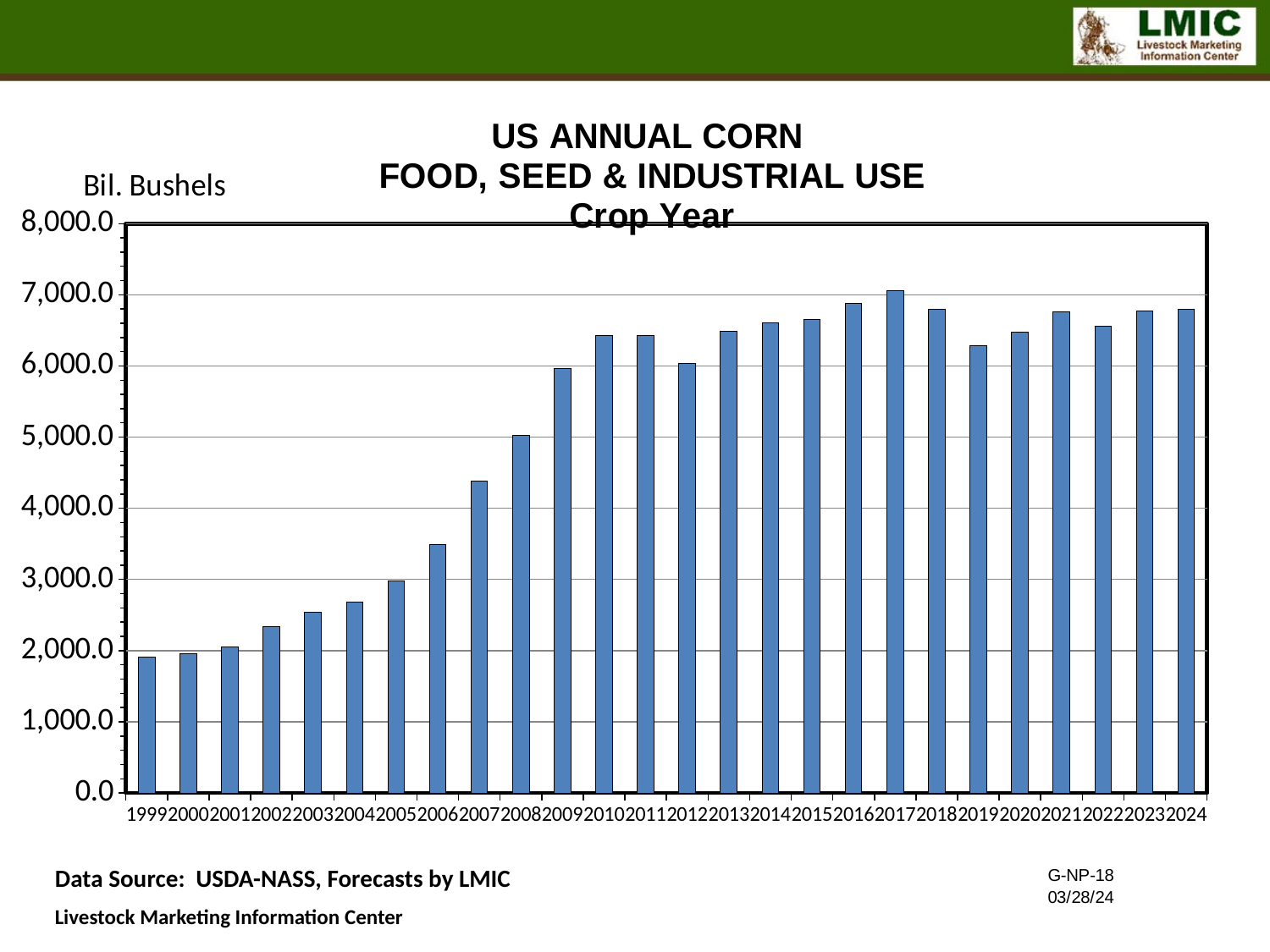
Is the value for 2019 greater or less than 6,000.0? greater What unit is shown on the vertical axis label? Bil. Bushels Which is larger, the value for 2018 or the value for 2019? 2018 Do the values rise or fall from 1999 to 2008? rise Is the value for 2007 greater or less than 5,000.0? less Is the value for 2016 greater or less than 7,000.0? less Which is larger, the value for 2012 or the value for 2013? 2013 How many crop years are plotted on the chart? 26 What kind of chart is shown on the slide? bar chart Which crop year has the highest food, seed & industrial use? 2017